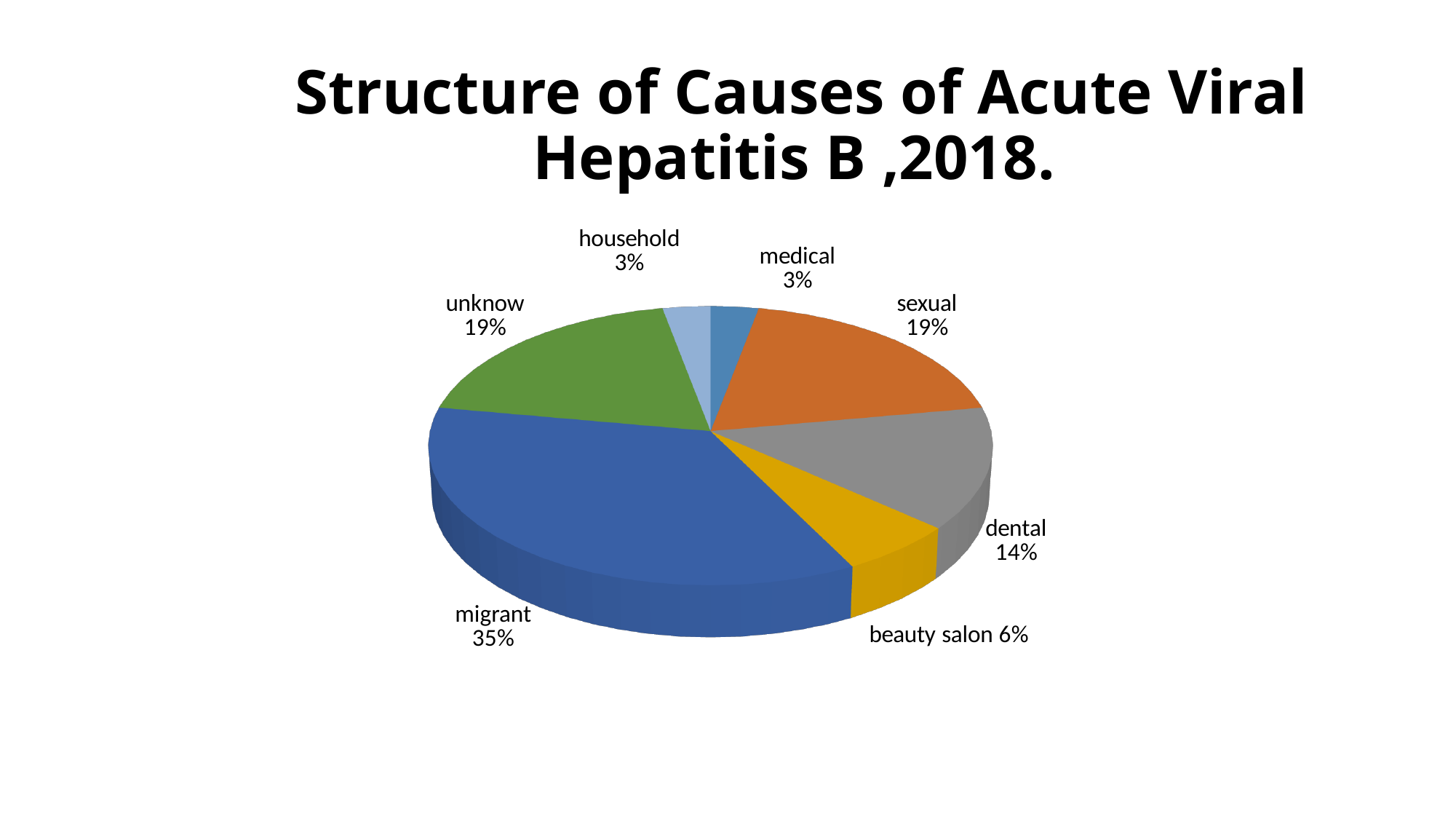
Which is larger, the dental share or the beauty salon share? dental What is the value shown for sexual? 19% What colour is the migrant slice? blue What is the difference between the migrant share and the unknow share? 16% What is the title of the chart? Structure of Causes of Acute Viral Hepatitis B ,2018. What is the value shown for beauty salon? 6% What is the combined share of household and medical? 6% What share of causes does migrant account for? 35% How many categories are shown in the pie chart? 7 Which category has the largest slice? migrant What kind of chart is shown on the slide? pie chart What is the value shown for dental? 14%